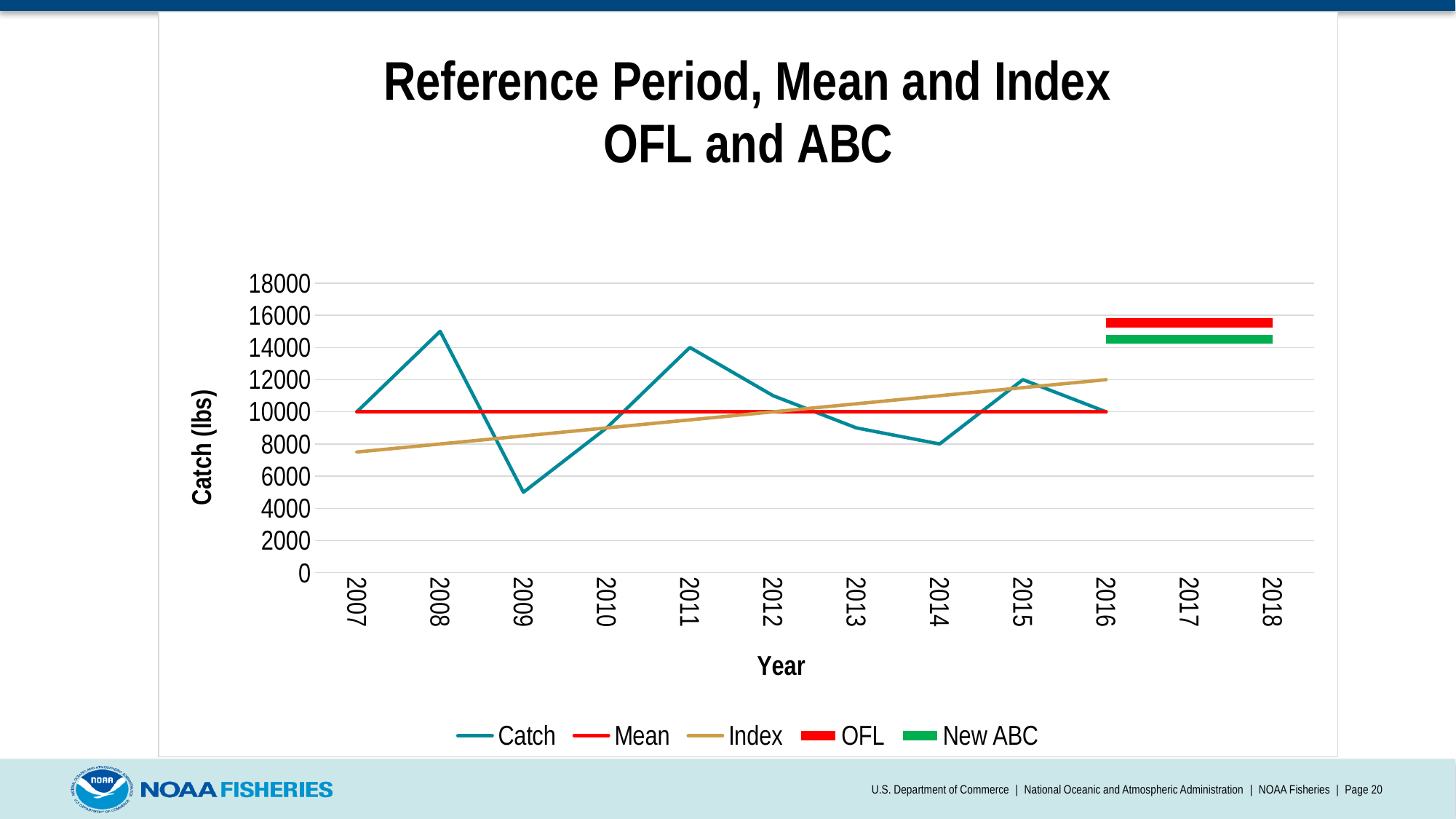
Is the OFL value greater or less than 14000? greater Is the Catch value for 2008 greater or less than 14000? greater Is the New ABC value greater or less than 16000? less What kind of chart is shown on the slide? line chart What is the value of the Mean line? 10000 Which is larger, the OFL value or the New ABC value? OFL How many series does the legend list? 5 Which year has the lowest Catch value? 2009 How many years are labelled on the x axis? 12 Does the Index line rise or fall from 2007 to 2018? rise Which year has the highest Catch value? 2008